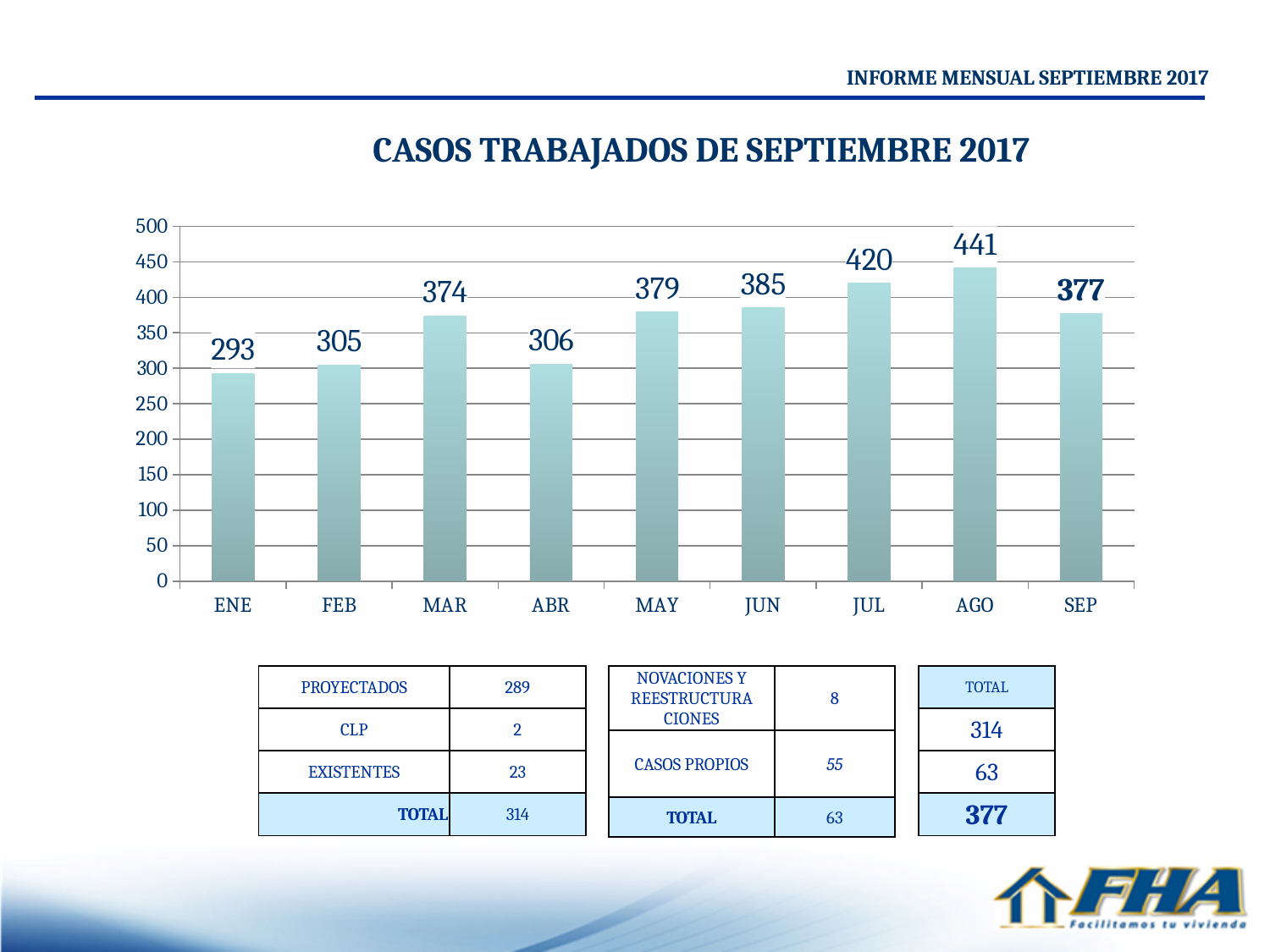
Which month has the highest value? AGO What is the value for SEP? 377 What kind of chart is shown on the slide? bar chart What is the difference between the values for JUL and ENE? 127 Which month has the lowest value? ENE How many months are shown on the x axis? 9 What is the difference between the values for AGO and SEP? 64 What is the value for MAR? 374 What is the title of the chart? CASOS TRABAJADOS DE SEPTIEMBRE 2017 What is the value for JUN? 385 Is the value for JUL greater or less than 400? greater Which is larger, the value for FEB or the value for ABR? ABR